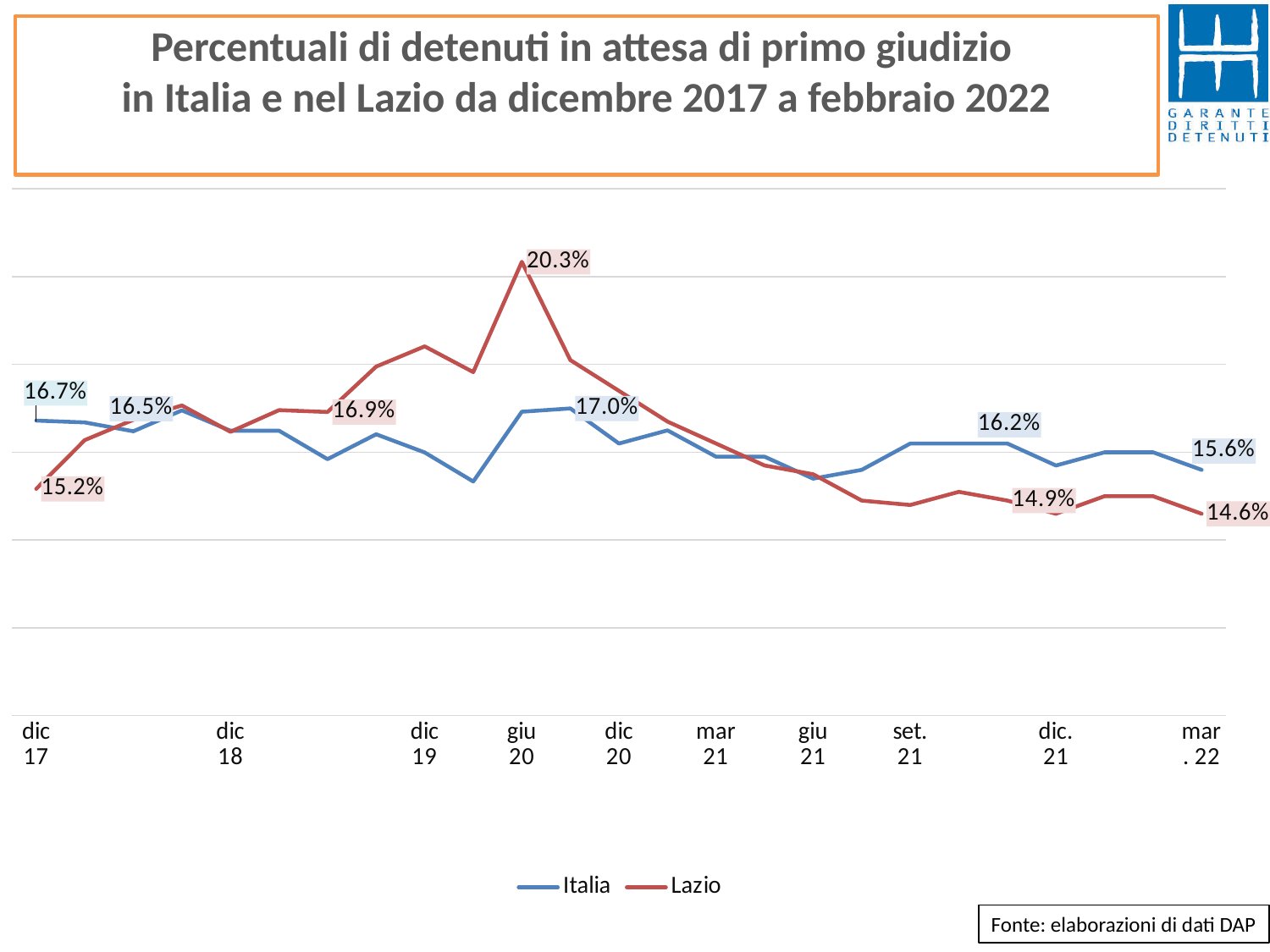
What is the value for Lazio at giu 20? 20.3% Which series is drawn in red? Lazio What is the difference between the Italia and Lazio values at mar. 22? 1.0 percentage points How many series does the legend list? 2 Does the Lazio line rise or fall from giu 20 to mar. 22? fall What is the difference between the Italia and Lazio values at dic 17? 1.5 percentage points Which series has the larger value at dic. 21, Italia or Lazio? Italia What is the value for Italia at dic 17? 16.7% At which point on the x axis does the Lazio line reach its highest value? giu 20 What is the value for Lazio at mar. 22? 14.6% What type of chart is shown on the slide? line chart